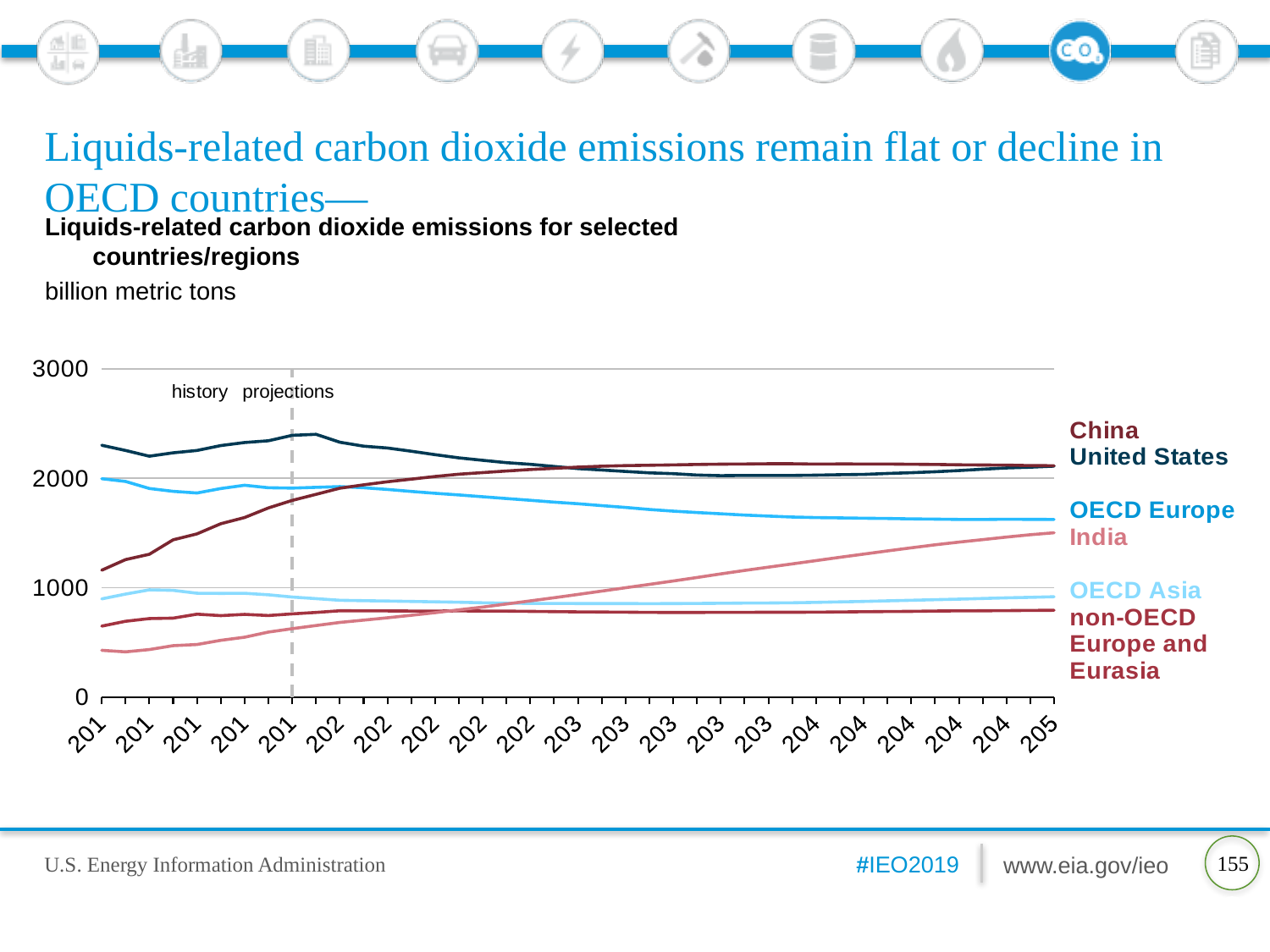
Is the value for India at the end of the period greater or less than 1000? greater Which series has the lowest value at the start of the period? India What unit is used for the values on the chart? billion metric tons At the start of the period, which is larger: the value for the United States or the value for China? United States Which series has the highest value at the start of the period? United States Does the value for OECD Europe rise or fall over the projection period? fall What kind of chart is shown on the slide? line chart Does the value for India rise or fall over the period shown? rise Is the value for the United States at the start of the period greater or less than 2000? greater Is the value for OECD Asia at the end of the period greater or less than 1000? less What do the two labels on either side of the dashed vertical line say? history and projections How many series are plotted on the chart? 6